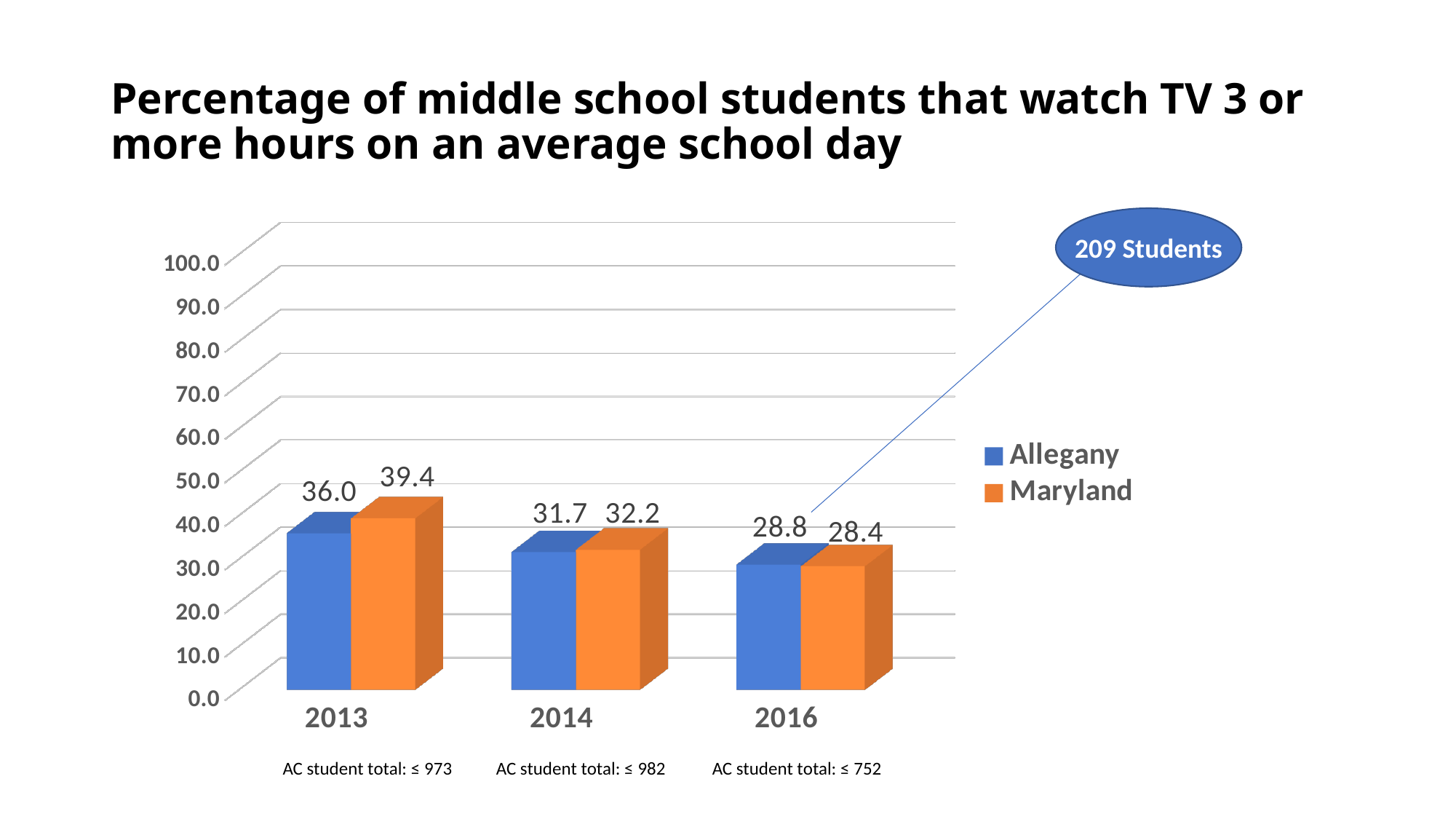
What is the difference between the Maryland and Allegany values in 2013? 3.4 What is the value for Maryland in 2014? 32.2 What is the value for Maryland in 2016? 28.4 What is the value for Allegany in 2013? 36.0 Do the Allegany values rise or fall from 2013 to 2016? fall In which year is the Allegany value lowest? 2016 How many series does the legend list? 2 In which year is the Maryland value highest? 2013 Which is larger in 2014, Allegany or Maryland? Maryland Is the value for Allegany in 2013 greater or less than 30.0? greater What kind of chart is shown? bar chart How many years are shown on the x axis? 3